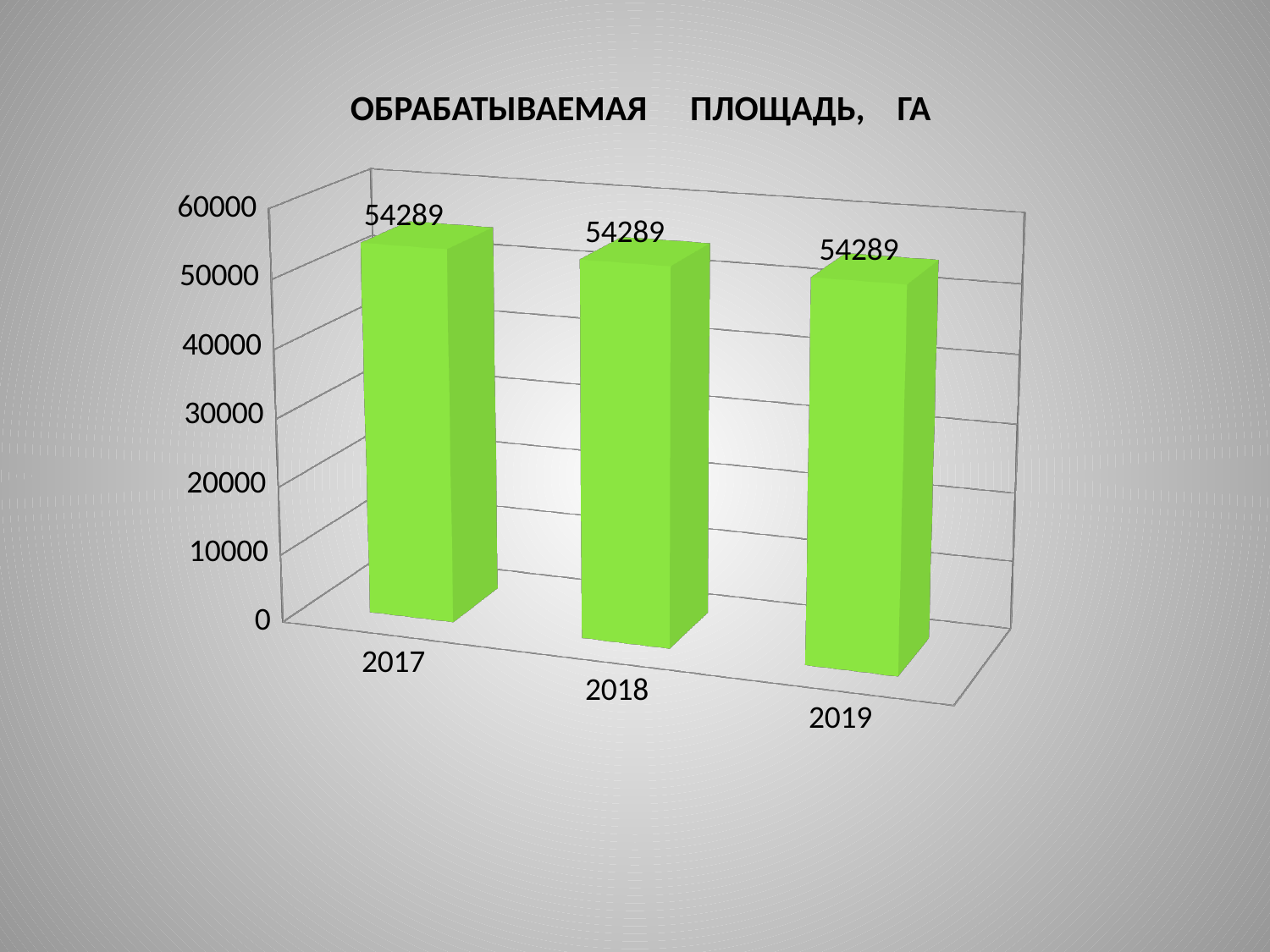
What is the value for 2018? 54289 Is the value for 2019 greater or less than 50000? greater What is the value for 2019? 54289 What kind of chart is shown on the slide? Bar chart Is the value for 2018 larger than, smaller than, or equal to the value for 2017? Equal Is the value for 2017 greater or less than 60000? less What colour are the bars in the chart? Green How many categories (years) are shown on the x axis? 3 Do the values rise, fall, or stay the same from 2017 to 2019? Stay the same What is the difference between the values for 2019 and 2017? 0 What is the title of the chart? ОБРАБАТЫВАЕМАЯ ПЛОЩАДЬ, ГА What is the value for 2017? 54289